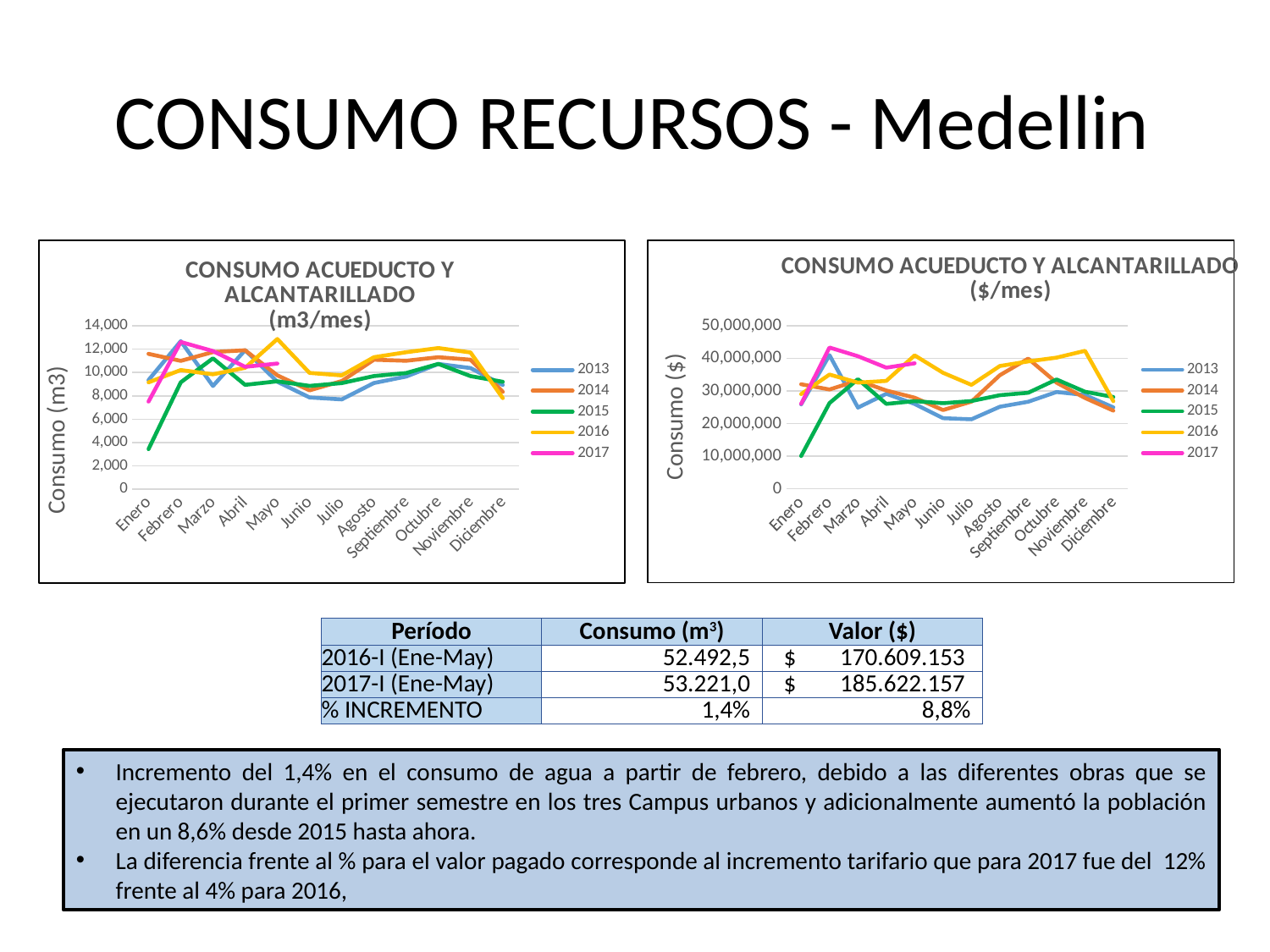
In the left chart (m3/mes), is the value for 2017 in Febrero greater or less than 10,000? greater In the right chart ($/mes), which is larger in Febrero: the value for 2017 or the value for 2015? 2017 In the right chart ($/mes), is the value for 2013 in Julio greater or less than 30,000,000? less What is the y-axis label of the left chart? Consumo (m3) What kind of chart is the left chart titled 'CONSUMO ACUEDUCTO Y ALCANTARILLADO (m3/mes)'? Line chart In the left chart (m3/mes), which series has the highest value in Enero? 2014 How many series does the legend of the right chart 'CONSUMO ACUEDUCTO Y ALCANTARILLADO ($/mes)' list? 5 In the right chart ($/mes), is the value for 2017 in Febrero greater or less than 40,000,000? greater In the left chart (m3/mes), which series has the lowest value in Enero? 2015 How many months are shown on the x axis of the left chart (m3/mes)? 12 What is the title of the right chart? CONSUMO ACUEDUCTO Y ALCANTARILLADO ($/mes)